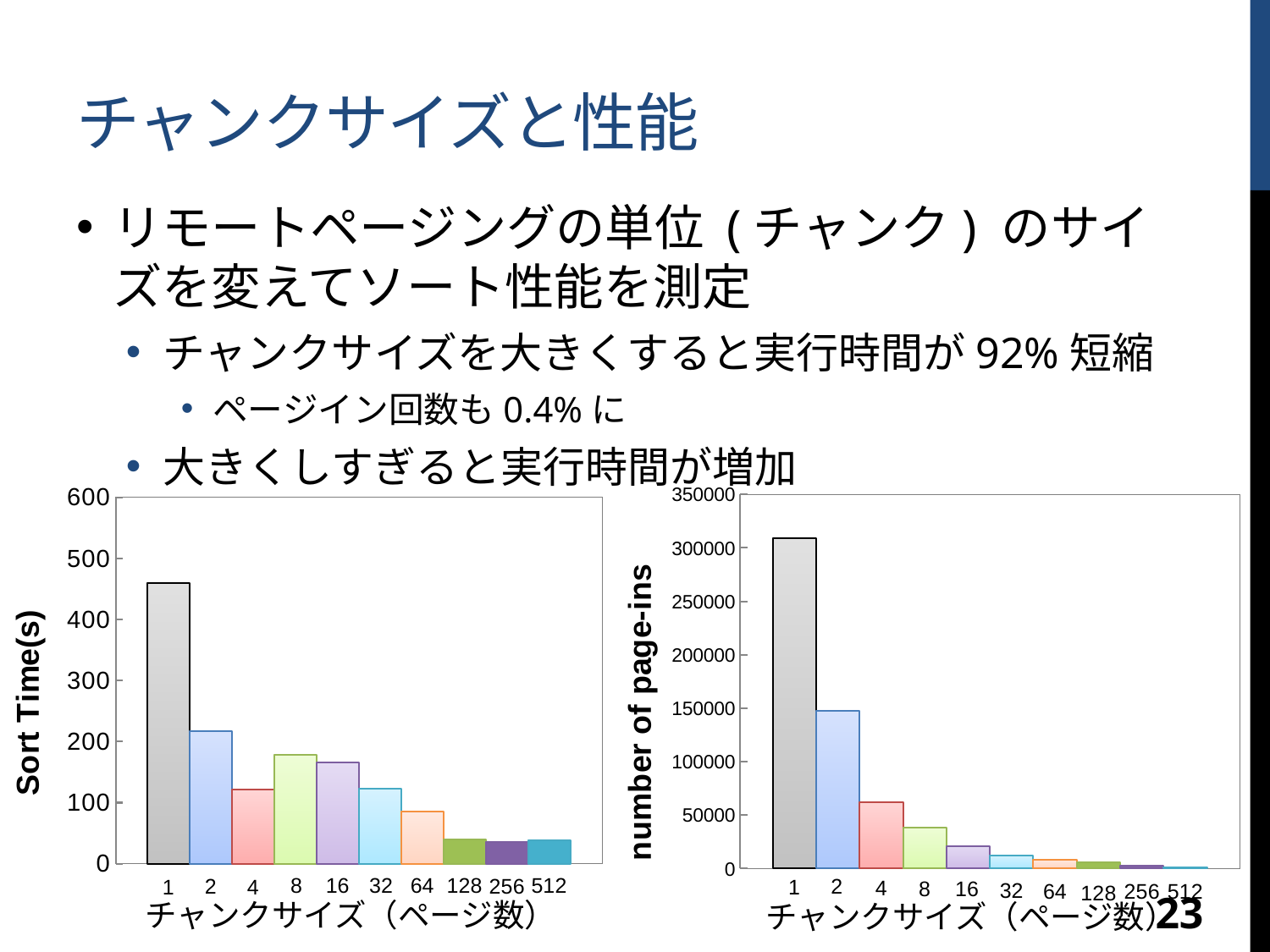
In the left chart (Sort Time(s)), is the sort time for chunk size 64 greater or less than 100? less In the left chart (Sort Time(s)), which chunk size has the highest sort time? 1 How many chunk-size categories are shown on the x axis of the left chart (Sort Time(s))? 10 In the right chart (number of page-ins), do the values rise or fall as the chunk size increases along the x axis? fall What kind of chart is the right chart (number of page-ins)? bar chart What is the y-axis label of the right chart? number of page-ins What kind of chart is the left chart (Sort Time(s))? bar chart In the right chart (number of page-ins), is the value for chunk size 1 greater or less than 300000? greater In the left chart (Sort Time(s)), is the sort time for chunk size 1 greater or less than 400? greater In the left chart (Sort Time(s)), which has the larger sort time, chunk size 4 or chunk size 8? 8 In the right chart (number of page-ins), which chunk size has the highest number of page-ins? 1